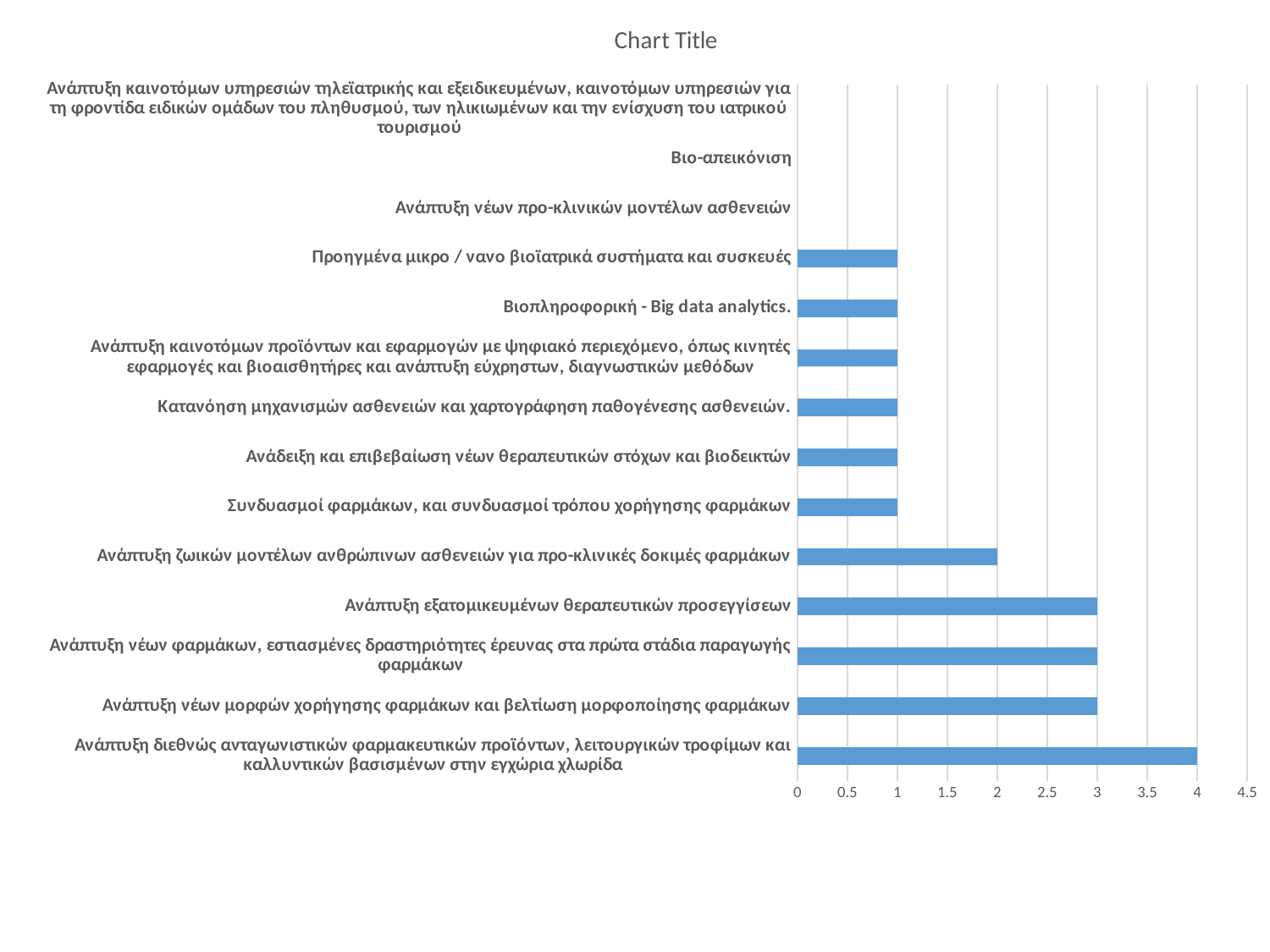
What is the value for Ανάπτυξη ζωικών μοντέλων ανθρώπινων ασθενειών για προ-κλινικές δοκιμές φαρμάκων? 2 Is the value for Προηγμένα μικρο / νανο βιοϊατρικά συστήματα και συσκευές greater or less than 2? less Which category has the highest value? Ανάπτυξη διεθνώς ανταγωνιστικών φαρμακευτικών προϊόντων, λειτουργικών τροφίμων και καλλυντικών βασισμένων στην εγχώρια χλωρίδα How many categories are shown on the chart? 14 Is the value for Ανάπτυξη νέων φαρμάκων, εστιασμένες δραστηριότητες έρευνας στα πρώτα στάδια παραγωγής φαρμάκων greater or less than 2? greater What is the value for Βιοπληροφορική - Big data analytics.? 1 What type of chart is shown on the slide? Bar chart What is the value for Ανάπτυξη εξατομικευμένων θεραπευτικών προσεγγίσεων? 3 What is the title of the chart? Chart Title Which is larger: the value for Ανάπτυξη ζωικών μοντέλων ανθρώπινων ασθενειών για προ-κλινικές δοκιμές φαρμάκων or the value for Κατανόηση μηχανισμών ασθενειών και χαρτογράφηση παθογένεσης ασθενειών.? Ανάπτυξη ζωικών μοντέλων ανθρώπινων ασθενειών για προ-κλινικές δοκιμές φαρμάκων What is the difference between the value for Ανάπτυξη νέων μορφών χορήγησης φαρμάκων και βελτίωση μορφοποίησης φαρμάκων and the value for Συνδυασμοί φαρμάκων, και συνδυασμοί τρόπου χορήγησης φαρμάκων? 2 What is the value for Ανάπτυξη διεθνώς ανταγωνιστικών φαρμακευτικών προϊόντων, λειτουργικών τροφίμων και καλλυντικών βασισμένων στην εγχώρια χλωρίδα? 4